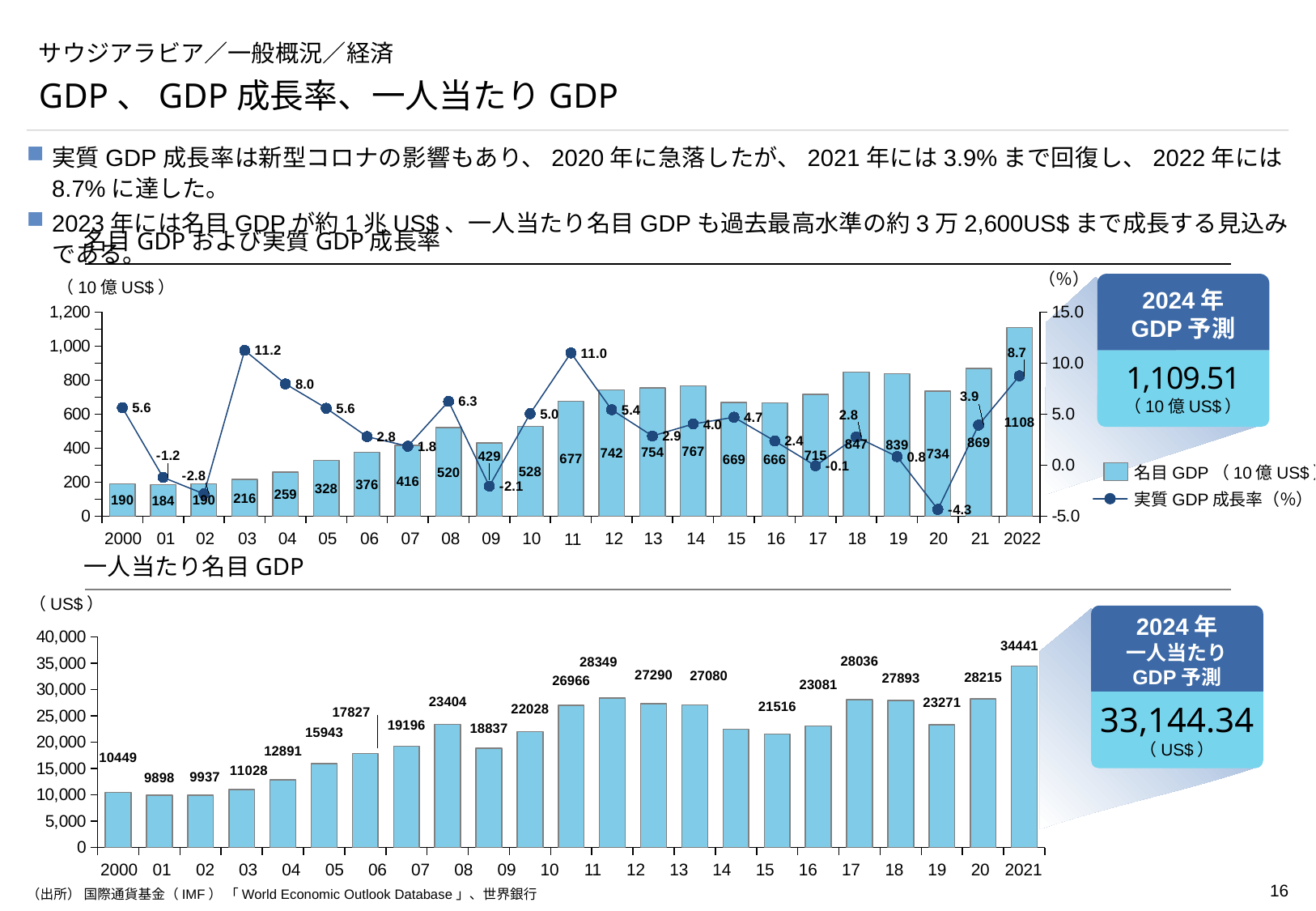
In the bottom chart (一人当たり名目GDP), what is the difference between the 2021 value and the 2000 value? 23992 In the bottom chart (一人当たり名目GDP), what kind of chart is it? Bar chart In the top chart (名目GDPおよび実質GDP成長率), what is the difference in nominal GDP between 2022 and 2021? 239 In the top chart (名目GDPおよび実質GDP成長率), is nominal GDP for 2018 larger than for 2019? Yes In the top chart (名目GDPおよび実質GDP成長率), what is the nominal GDP value for 2022? 1108 In the top chart (名目GDPおよび実質GDP成長率), which year has the highest real GDP growth rate? 2003 In the bottom chart (一人当たり名目GDP), how many years are plotted? 22 In the top chart (名目GDPおよび実質GDP成長率), how many series does the legend list? 2 In the top chart (名目GDPおよび実質GDP成長率), what is the real GDP growth rate for 2020? -4.3 In the bottom chart (一人当たり名目GDP), what is the value for 2021? 34441 In the bottom chart (一人当たり名目GDP), which year has the lowest value? 2001 In the top chart (名目GDPおよび実質GDP成長率), which year has the lowest real GDP growth rate? 2020